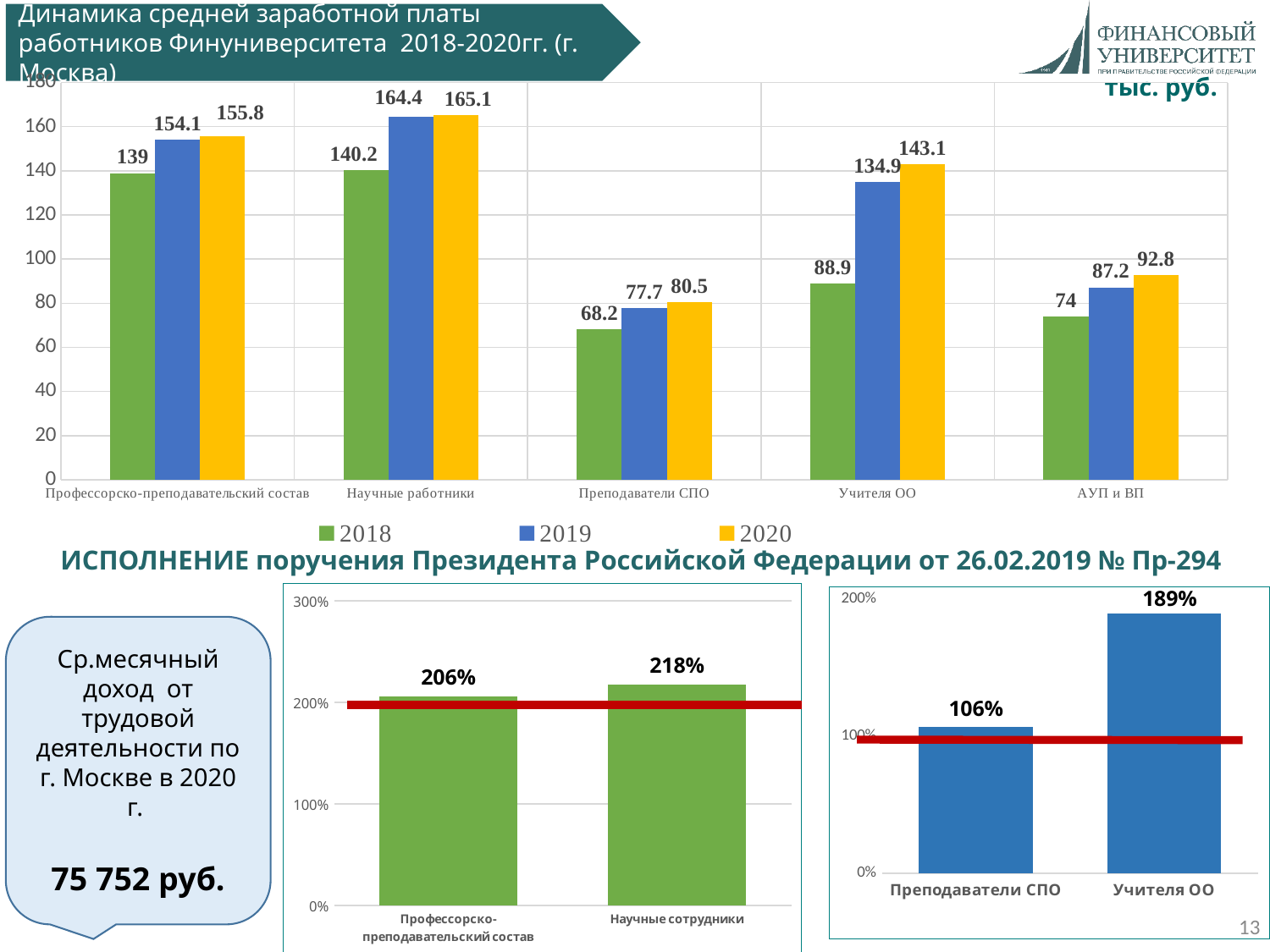
In the bottom-left chart, what is the value for Научные сотрудники? 218% In the top chart, what is the 2020 value for Научные работники? 165.1 In the top chart, which is larger: the 2019 value for АУП и ВП or the 2019 value for Преподаватели СПО? АУП и ВП In the top chart, do the values for Профессорско-преподавательский состав rise or fall from 2018 to 2020? rise How many categories are shown on the x axis of the top chart? 5 In the top chart, which category has the lowest 2020 value? Преподаватели СПО What kind of chart is the bottom-right chart? bar chart In the top chart, what is the 2018 value for Преподаватели СПО? 68.2 In the top chart, which category has the highest 2019 value? Научные работники In the top chart, what is the difference between the 2020 and 2018 values for Учителя ОО? 54.2 How many series does the legend of the top chart list? 3 In the bottom-right chart, what is the value for Учителя ОО? 189%